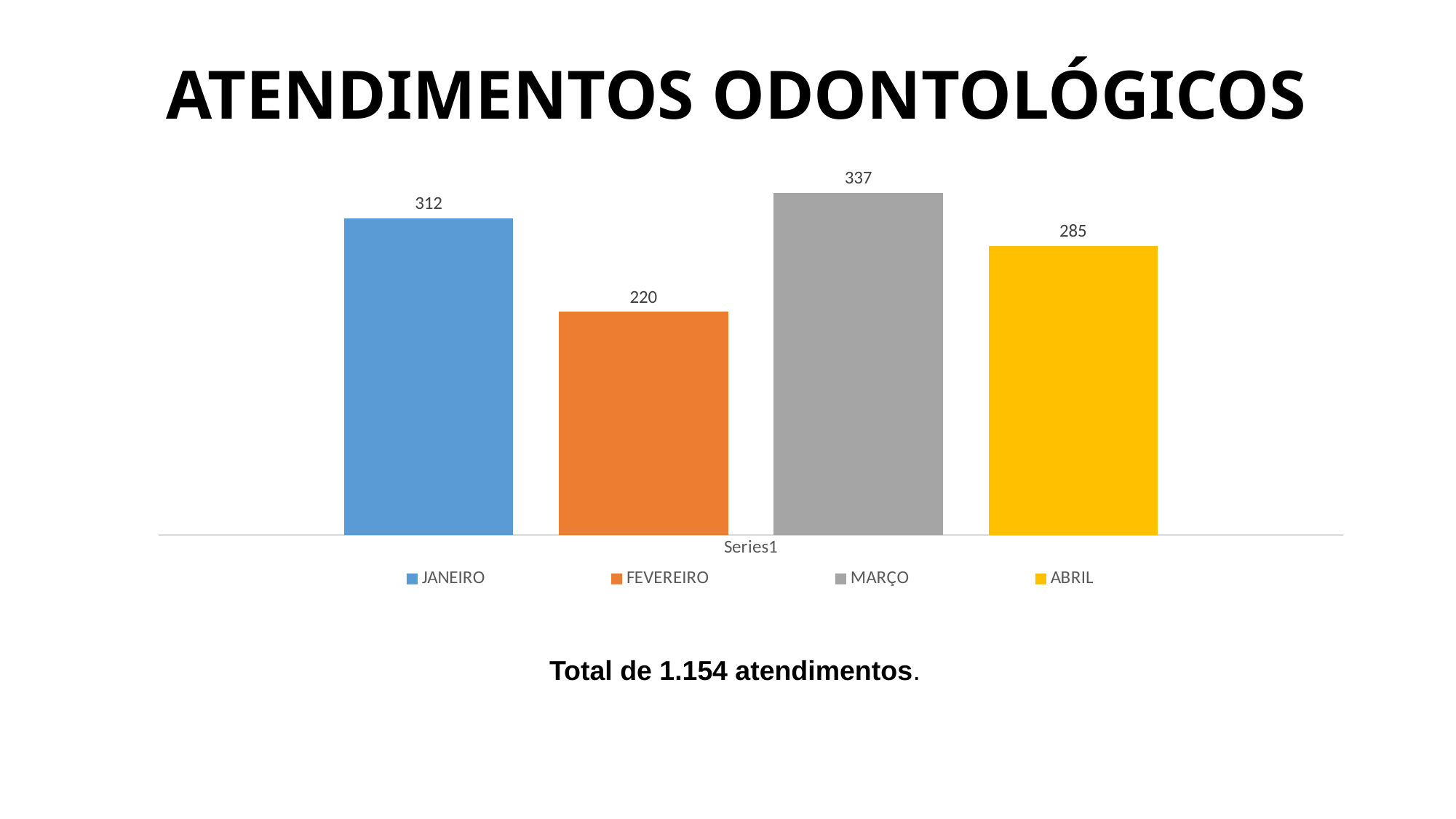
What is the value for MARÇO? 337 What kind of chart is shown on the slide? Bar chart What is the value for JANEIRO? 312 Which month has the lowest value? FEVEREIRO What is the difference between the values for JANEIRO and ABRIL? 27 What colour is the bar for MARÇO? Grey What is the value for ABRIL? 285 Which month has the highest value? MARÇO What is the difference between the values for MARÇO and FEVEREIRO? 117 What is the value for FEVEREIRO? 220 Which is larger, the value for JANEIRO or the value for ABRIL? JANEIRO How many bars are shown in the chart? 4